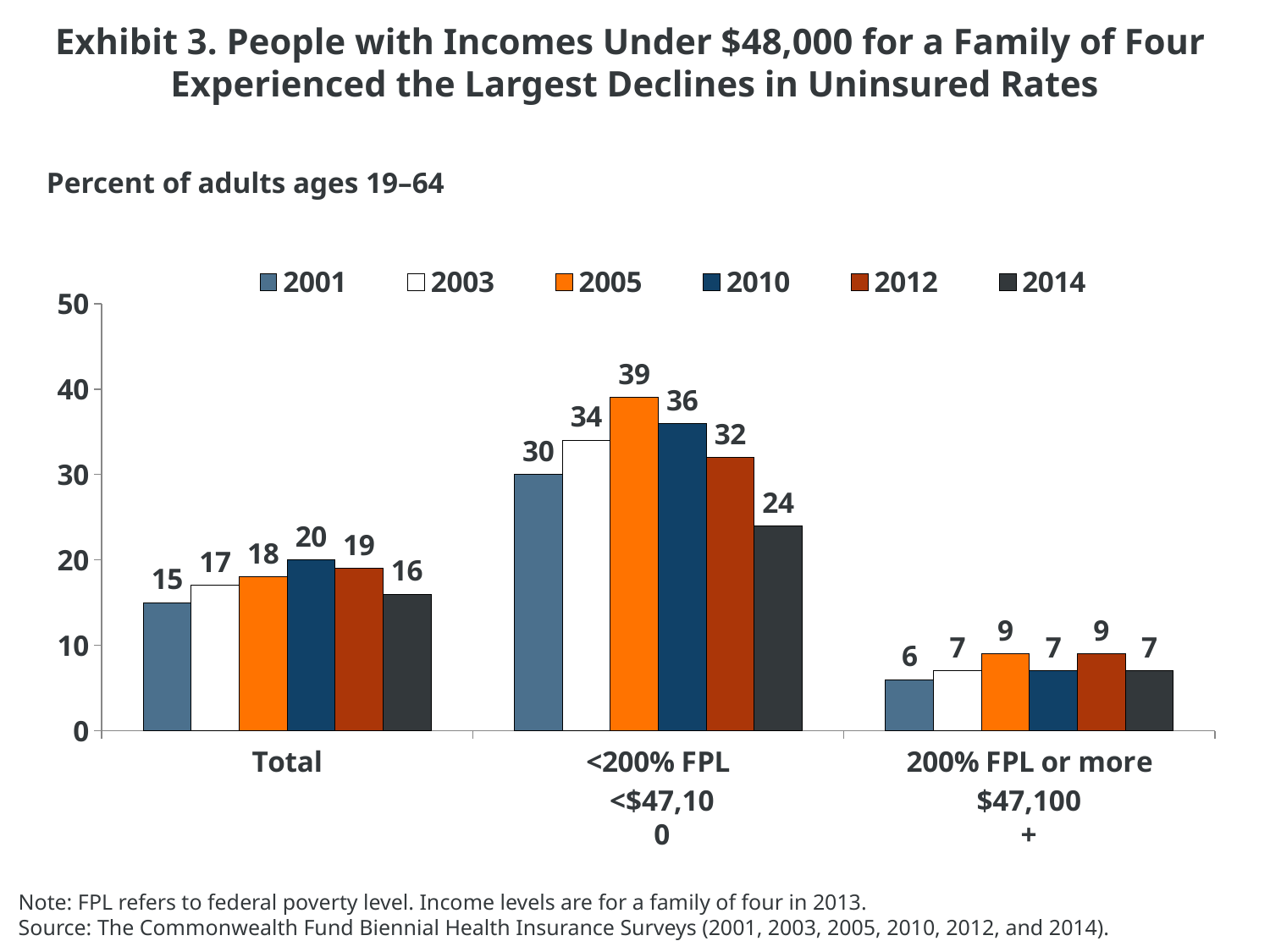
How many series does the legend list? 6 Which is larger in the Total category: the value for 2010 or the value for 2012? 2010 How many categories are shown on the x axis? 3 What is the value for 2001 in the 200% FPL or more category? 6 Is the value for 2003 in the <200% FPL category greater or less than 30? greater What kind of chart is shown on the slide? bar chart What is the value for 2014 in the <200% FPL category? 24 What is the value for 2005 in the Total category? 18 What is the subtitle shown above the chart describing the measure? Percent of adults ages 19–64 Which year has the highest value in the <200% FPL category? 2005 Which year has the lowest value in the Total category? 2001 What is the difference between the 2005 and 2014 values in the <200% FPL category? 15